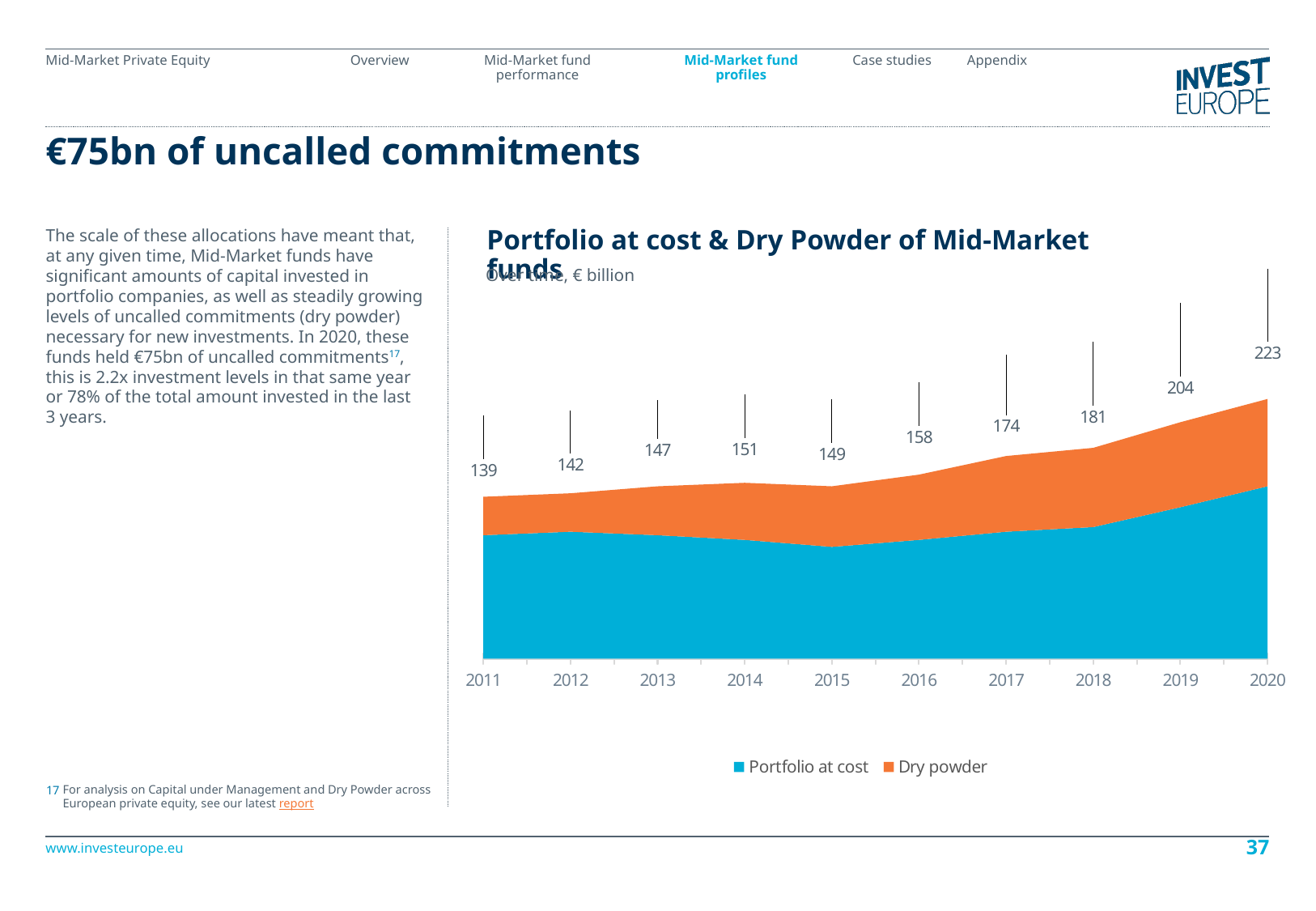
What is the total value shown for 2020? 223 Which series is shown in orange in the legend? Dry powder Which year has a larger total value, 2014 or 2015? 2014 What is the total value shown for 2017? 174 Which year has the highest total value? 2020 What is the difference between the total values for 2015 and 2014? 2 What kind of chart is shown on the slide? Stacked area chart Which year has the lowest total value? 2011 How many series does the legend list? 2 What is the difference between the total values for 2020 and 2019? 19 How many years are shown on the x axis? 10 What is the total value shown for 2011? 139